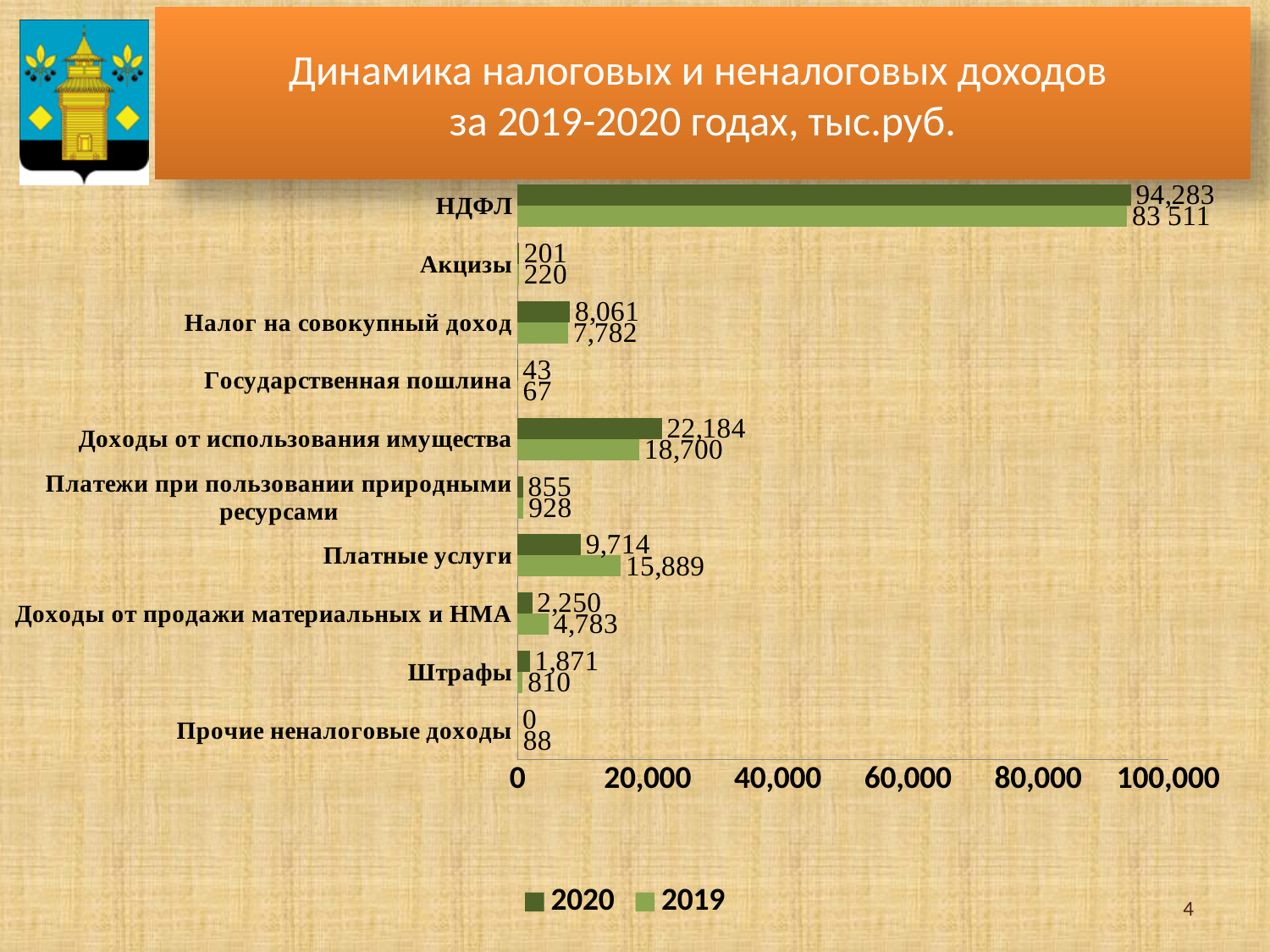
Which category has the highest 2020 value? НДФЛ What is the difference between the 2019 and 2020 values for Платные услуги? 6,175 What is the 2020 value for Доходы от использования имущества? 22,184 What type of chart is shown on the slide? Bar chart What is the 2019 value for Платные услуги? 15,889 Which category has the lowest 2020 value? Прочие неналоговые доходы How many categories are shown on the chart? 10 What is the 2020 value for НДФЛ? 94,283 Which is larger for Штрафы, the 2020 value or the 2019 value? 2020 What is the difference between the 2020 and 2019 values for Налог на совокупный доход? 279 What is the 2019 value for Доходы от продажи материальных и НМА? 4,783 How many series does the legend list? 2